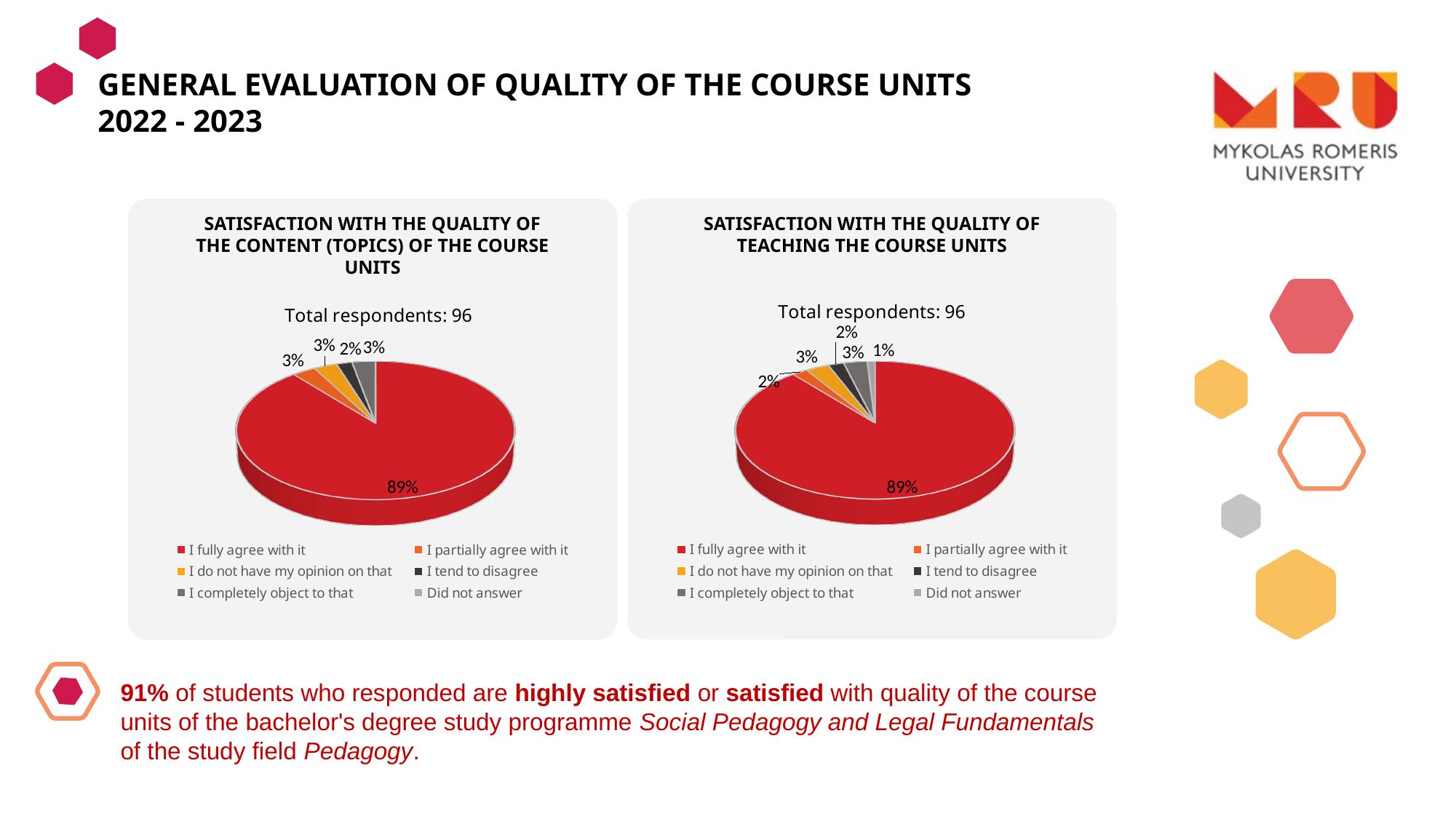
In the 'Satisfaction with the quality of teaching the course units' chart, which response has the smallest slice? Did not answer What kind of chart is the 'Satisfaction with the quality of the content (topics) of the course units' chart? Pie chart What colour is the 'I fully agree with it' slice in the 'Satisfaction with the quality of the content (topics) of the course units' chart? Red How many total respondents are reported for the 'Satisfaction with the quality of the content (topics) of the course units' chart? 96 In the 'Satisfaction with the quality of teaching the course units' chart, what share of respondents 'Did not answer'? 1% In the 'Satisfaction with the quality of teaching the course units' chart, which response has the largest slice? I fully agree with it How many pie charts are shown on the slide? 2 How many entries does the legend of the 'Satisfaction with the quality of teaching the course units' chart list? 6 In the 'Satisfaction with the quality of teaching the course units' chart, which is larger: 'I fully agree with it' or 'I partially agree with it'? I fully agree with it In the 'Satisfaction with the quality of the content (topics) of the course units' chart, which response has the largest slice? I fully agree with it In the 'Satisfaction with the quality of teaching the course units' chart, what share of respondents chose 'I fully agree with it'? 89% In the 'Satisfaction with the quality of the content (topics) of the course units' chart, what share of respondents chose 'I fully agree with it'? 89%